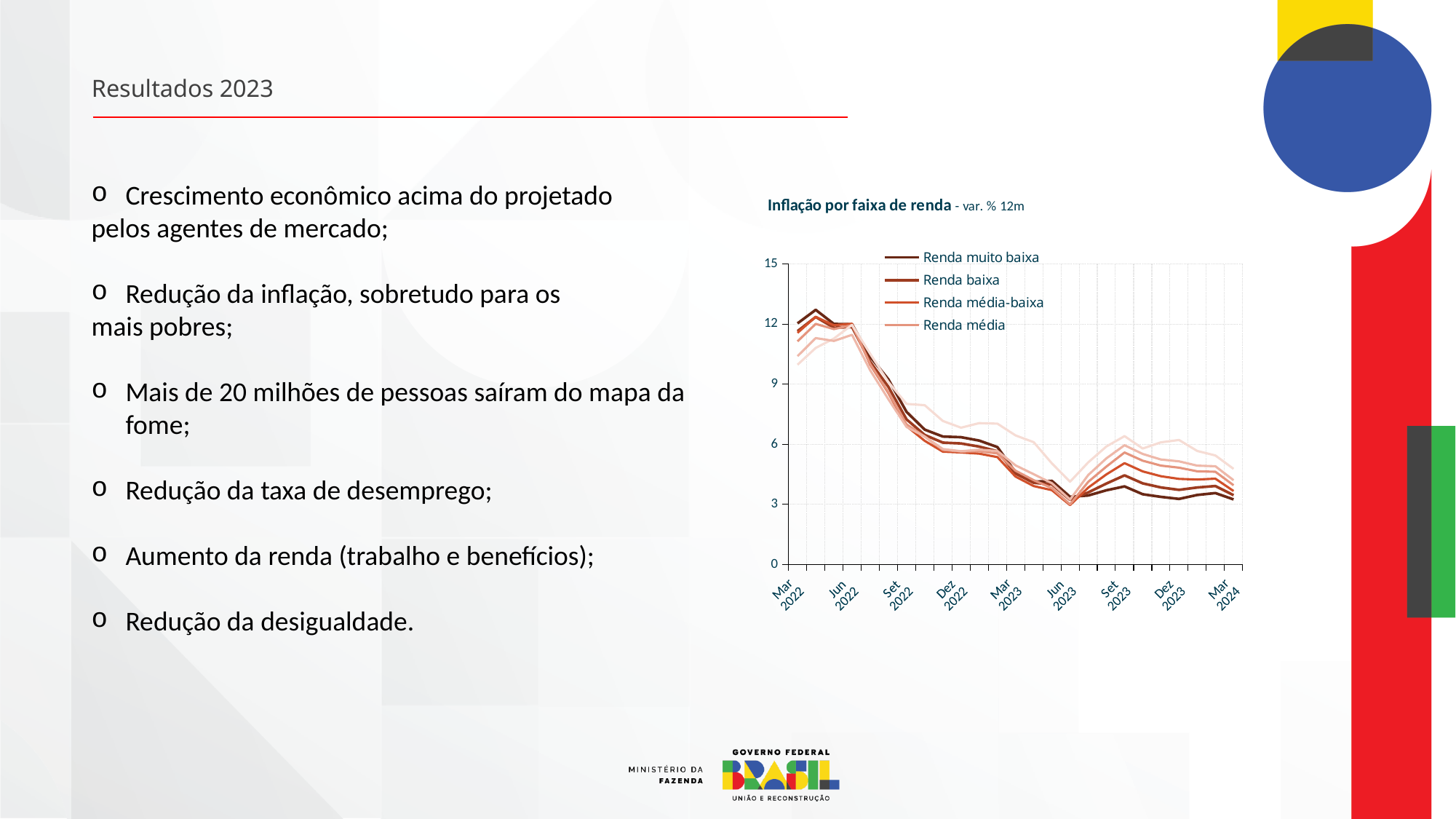
What kind of chart is shown on the slide? line chart At Mar 2022, which is larger: the value for Renda muito baixa or the value for Renda média? Renda muito baixa What is the title of the chart? Inflação por faixa de renda - var. % 12m Is the value for Renda muito baixa at Mar 2022 greater or less than 9? greater At Dec 2023, which is larger: the value for Renda média or the value for Renda muito baixa? Renda média Which series has the lowest value at Dec 2023? Renda muito baixa Is the value for Renda média at Jun 2023 greater or less than 6? less How many series does the legend of the chart list? 4 Overall, do the values in the chart rise or fall from Mar 2022 to Mar 2024? fall Is the value for Renda muito baixa at Sep 2023 greater or less than 6? less Which series is listed first in the chart legend? Renda muito baixa